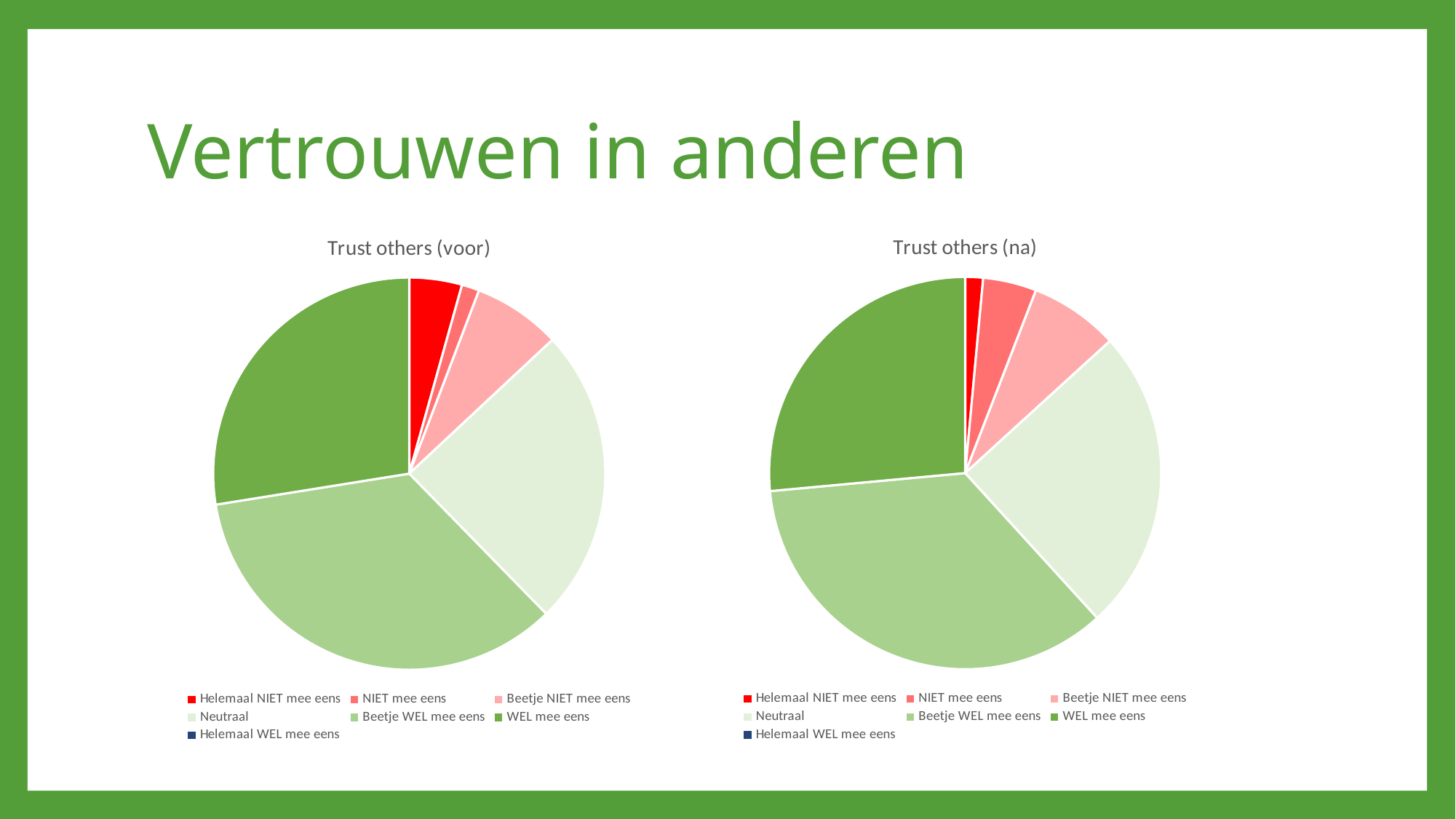
What kind of chart is "Trust others (voor)"? pie chart In "Trust others (voor)", which category has the largest slice? Beetje WEL mee eens How many categories does the legend of "Trust others (na)" list? 7 In "Trust others (na)", which category has the largest slice? Beetje WEL mee eens What is the title of the pie chart on the left of the slide? Trust others (voor) In "Trust others (voor)", which slice is larger: Neutraal or Beetje NIET mee eens? Neutraal How many categories does the legend of "Trust others (voor)" list? 7 In "Trust others (na)", which visible slice is the smallest? Helemaal NIET mee eens In "Trust others (na)", which slice is larger: WEL mee eens or NIET mee eens? WEL mee eens In "Trust others (voor)", which visible slice is the smallest? NIET mee eens In the legend of "Trust others (na)", what colour represents Helemaal NIET mee eens? red What kind of chart is "Trust others (na)"? pie chart